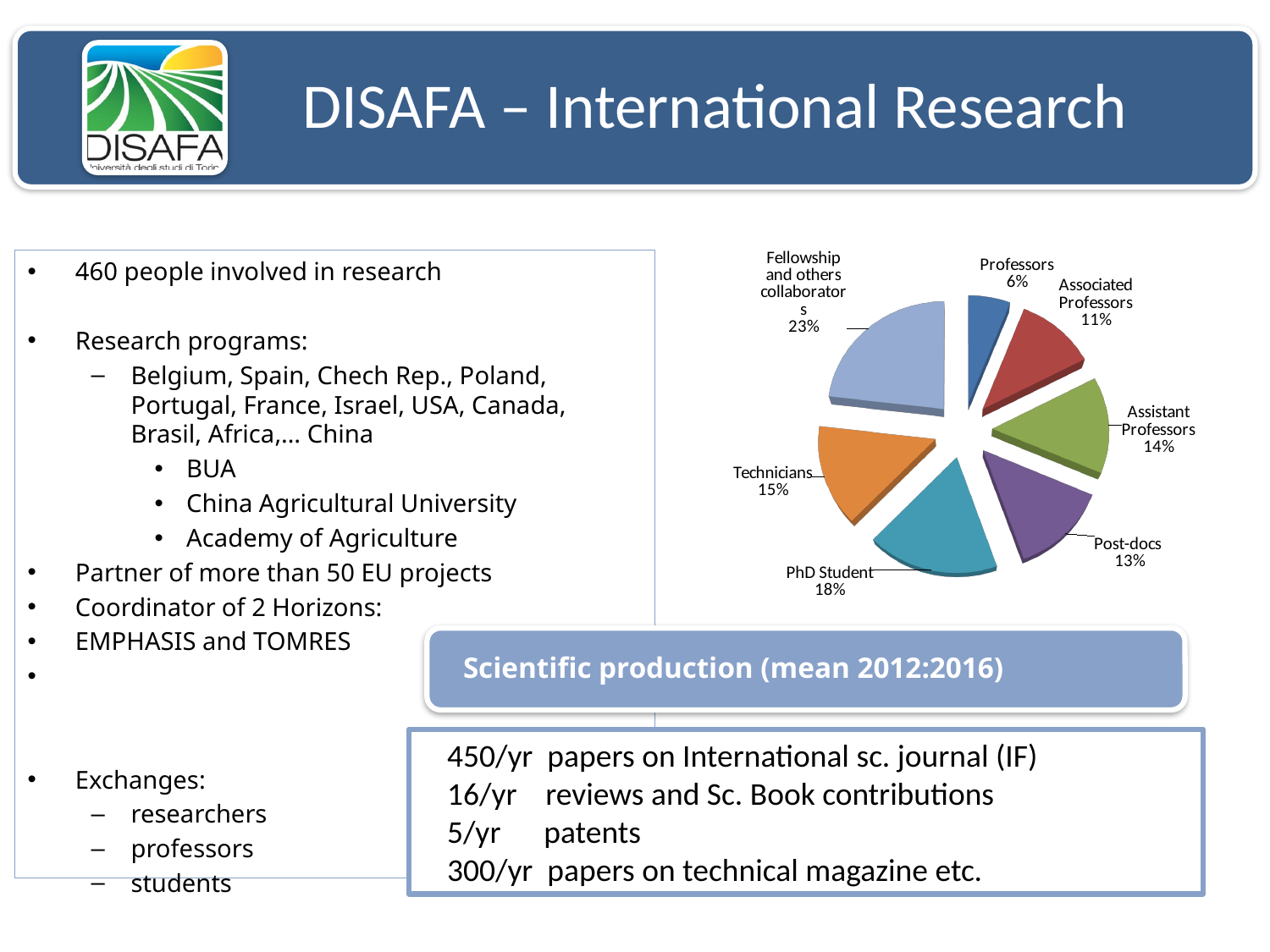
What share of the pie is Associated Professors? 11% What share of the pie is Professors? 6% What share of the pie is Assistant Professors? 14% What is the difference in percentage points between PhD Student and Post-docs? 5 Which is larger, the Technicians slice or the Assistant Professors slice? Technicians Which category has the largest slice of the pie? Fellowship and others collaborators Which category has the smallest slice of the pie? Professors What type of chart is shown on the slide? pie chart What share of the pie is Technicians? 15% What share of the pie is Post-docs? 13% How many slices does the pie chart have? 7 What share of the pie is PhD Student? 18%